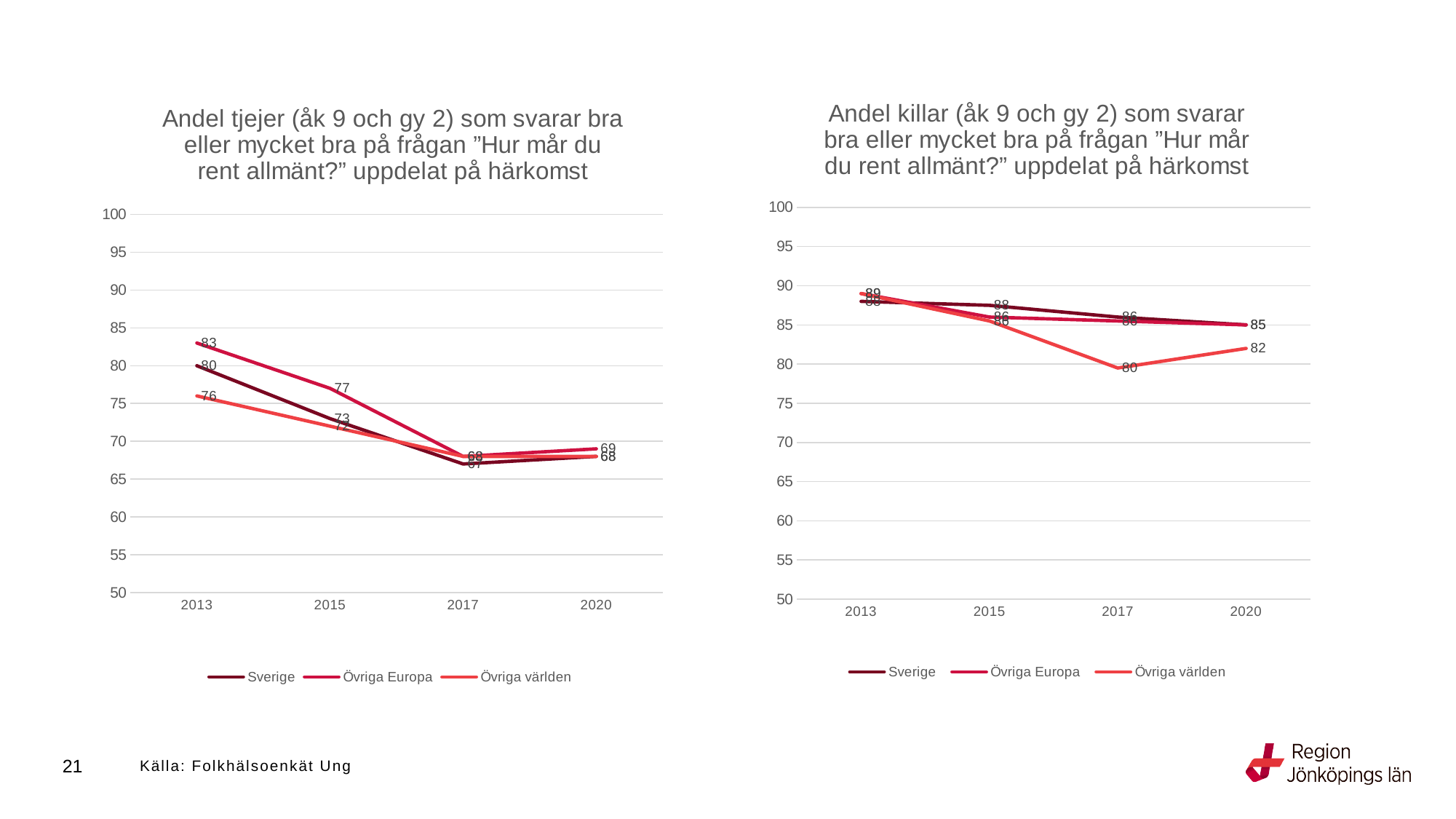
In the right chart (Andel killar), what is the value for Övriga världen in 2017? 80 How many series does the legend of the right chart (Andel killar) list? 3 In the right chart (Andel killar), what is the value for Övriga världen in 2020? 82 In the left chart (Andel tjejer), what is the value for Övriga Europa in 2013? 83 In the left chart (Andel tjejer), what is the value for Sverige in 2013? 80 In the left chart (Andel tjejer), which series has the highest value in 2013? Övriga Europa What kind of chart is the left chart about tjejer? line chart In the left chart (Andel tjejer), is the value for Sverige in 2015 greater or less than 75? less In the left chart (Andel tjejer), what is the value for Övriga Europa in 2015? 77 In the left chart (Andel tjejer), what is the value for Övriga världen in 2013? 76 In the left chart (Andel tjejer), what is the difference between Övriga Europa and Övriga världen in 2013? 7 In the right chart (Andel killar), which series has the lowest value in 2017? Övriga världen